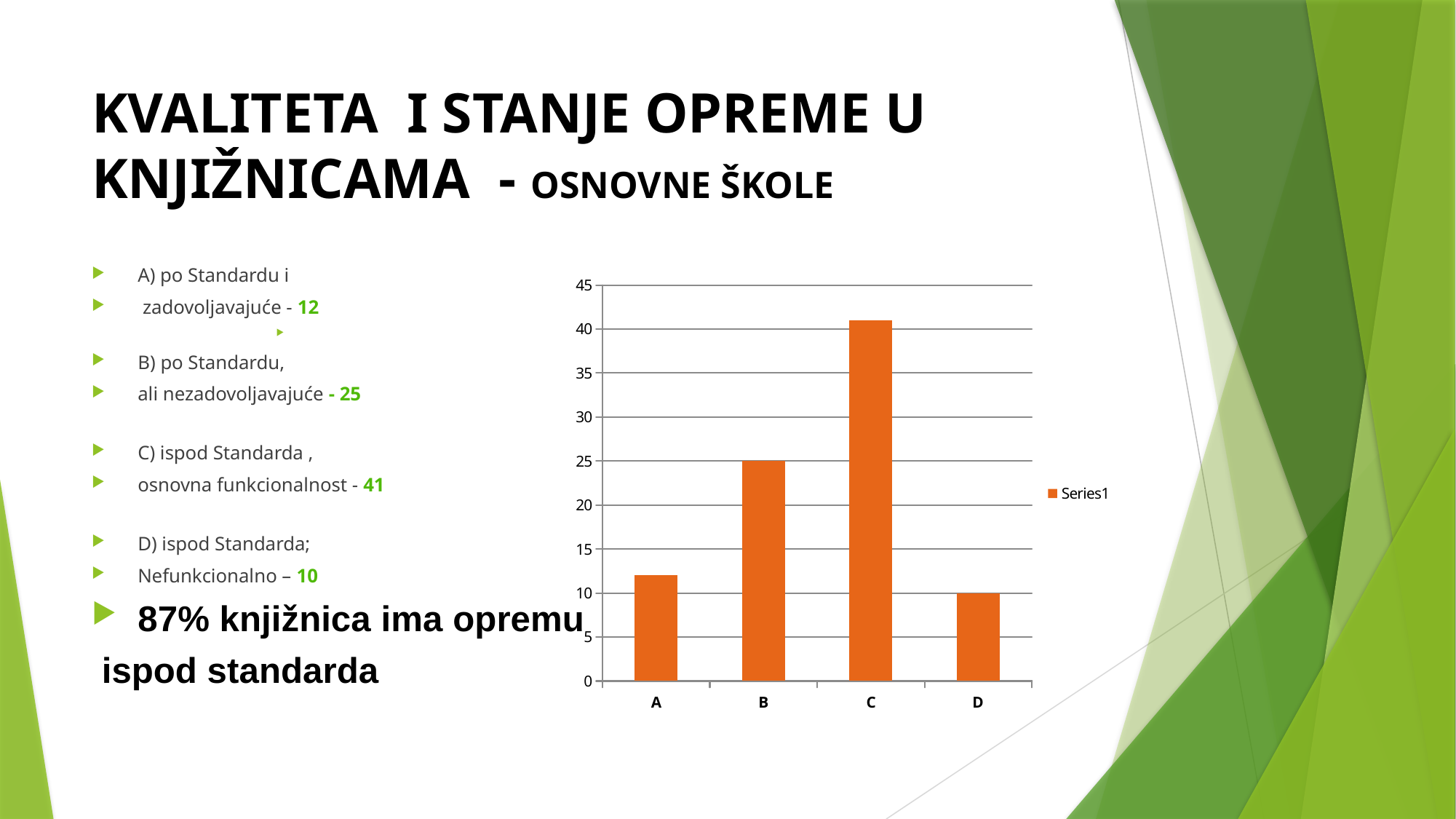
What is the name of the series in the chart legend? Series1 What is the value for category B in the chart? 25 Which category has the lowest bar in the chart? D What is the difference between the values for B and D in the chart? 15 Which category has the highest bar in the chart? C Is the value for category A greater or less than 15? less How many series does the chart legend list? 1 Which is larger in the chart, the value for B or the value for A? B How many categories are shown on the x axis of the chart? 4 Is the value for category C greater or less than 40? greater What is the value for category D in the chart? 10 What kind of chart is shown on the slide? bar chart